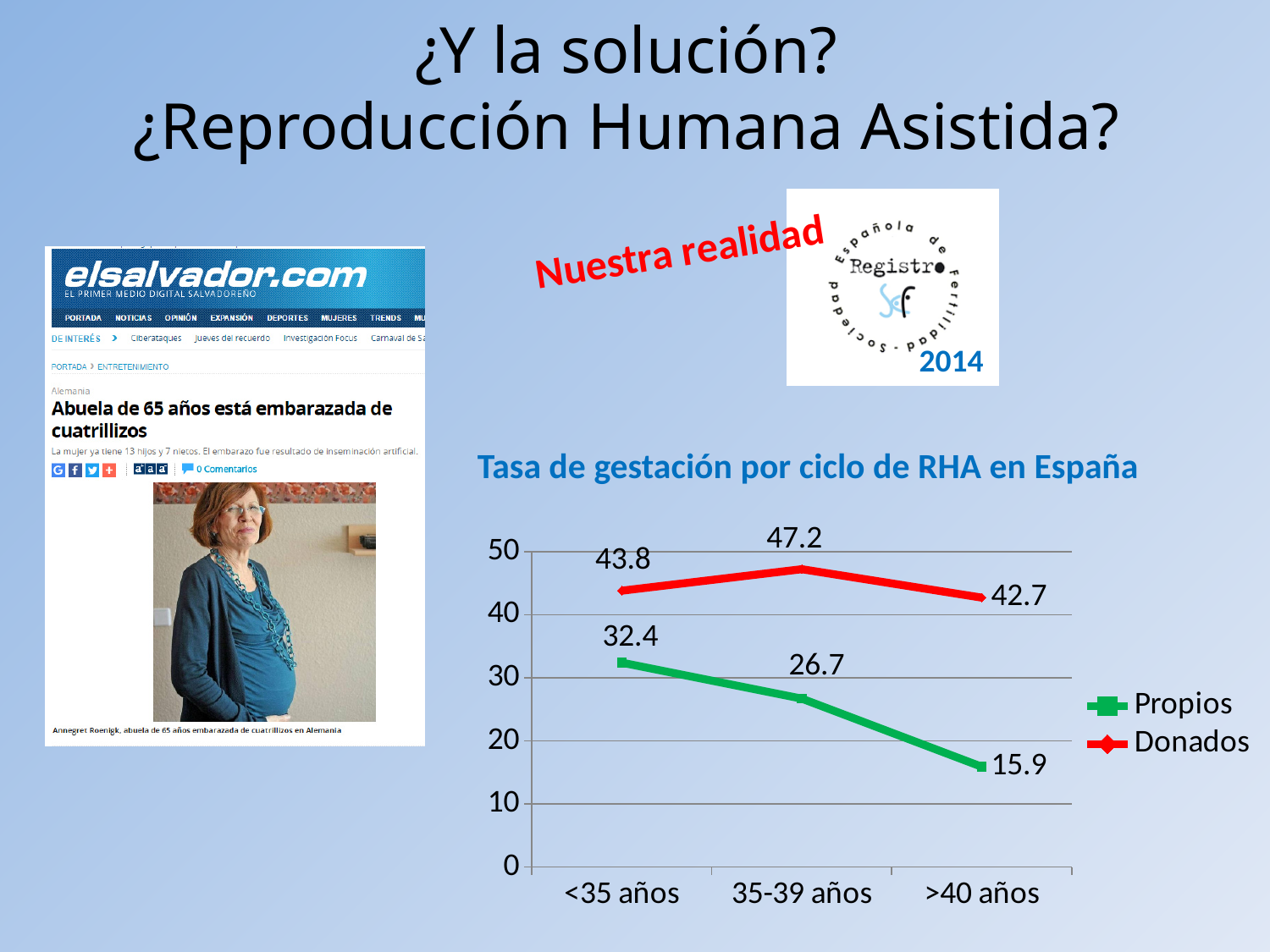
How many age groups are shown on the x axis? 3 What is the difference between Donados and Propios at >40 años? 26.8 What is the value for Donados at 35-39 años? 47.2 Which age group has the lowest value for Propios? >40 años How many series does the legend list? 2 What is the value for Propios at >40 años? 15.9 Does the Propios series rise or fall across the age groups from left to right? Fall What is the value for Propios at <35 años? 32.4 What kind of chart is shown? Line chart Which age group has the highest value for Donados? 35-39 años What is the value for Donados at >40 años? 42.7 Which is larger at <35 años, Propios or Donados? Donados